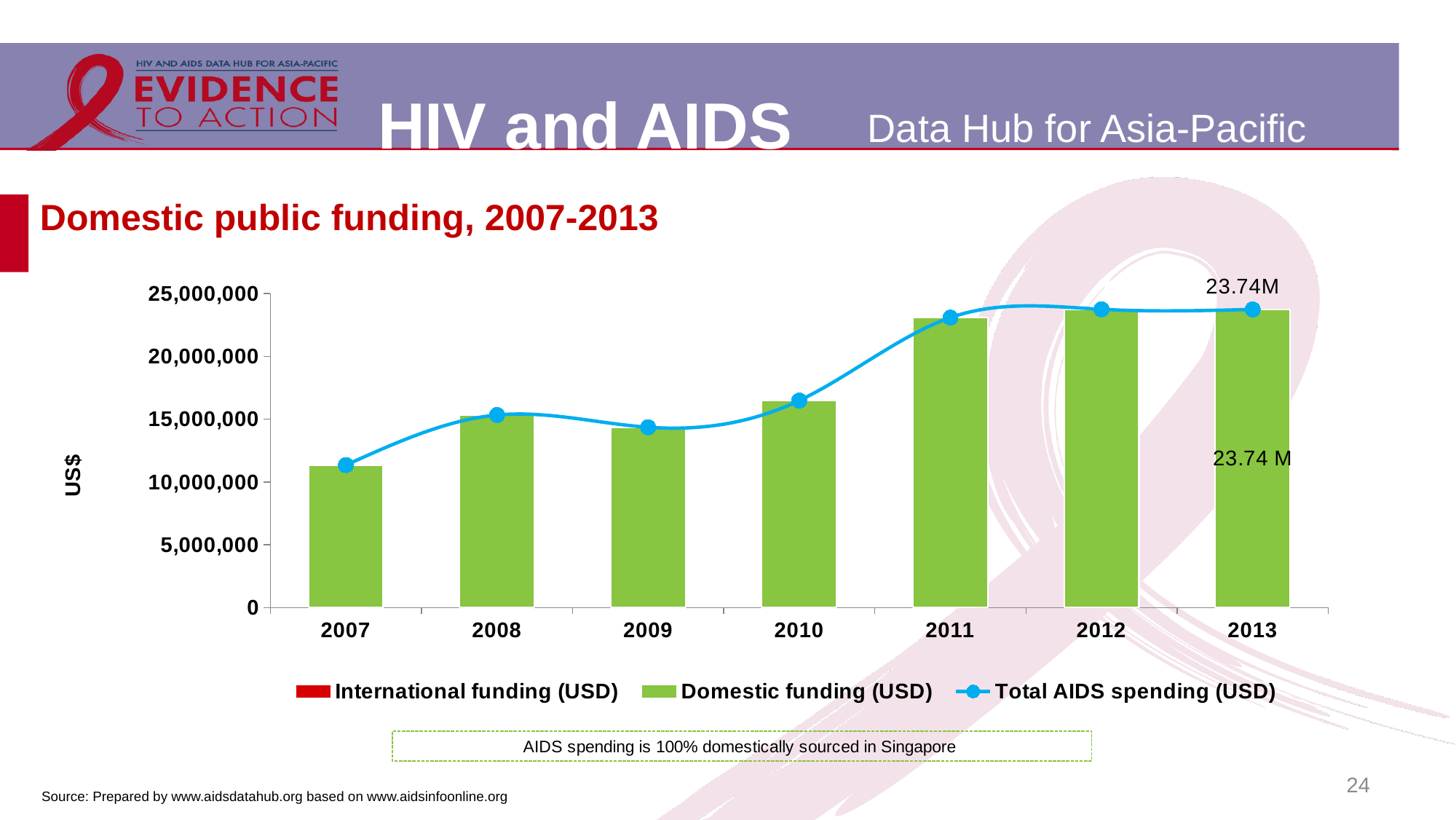
How many series does the chart legend list? 3 What is the labelled value of Domestic funding (USD) for 2013? 23.74 M How many years are shown on the x axis of the chart? 7 What kind of chart is shown on the slide? Bar chart with a line Does Total AIDS spending (USD) generally rise or fall from 2007 to 2013? rise What is the labelled value of Total AIDS spending (USD) for 2013? 23.74M Is the Domestic funding (USD) for 2011 greater or less than 20,000,000? greater Is the Domestic funding (USD) for 2007 greater or less than 15,000,000? less Is the Domestic funding (USD) for 2010 greater or less than 15,000,000? greater Which year has higher Domestic funding (USD), 2008 or 2009? 2008 Which year has the lowest Domestic funding (USD)? 2007 What is the title of the chart on the slide? Domestic public funding, 2007-2013